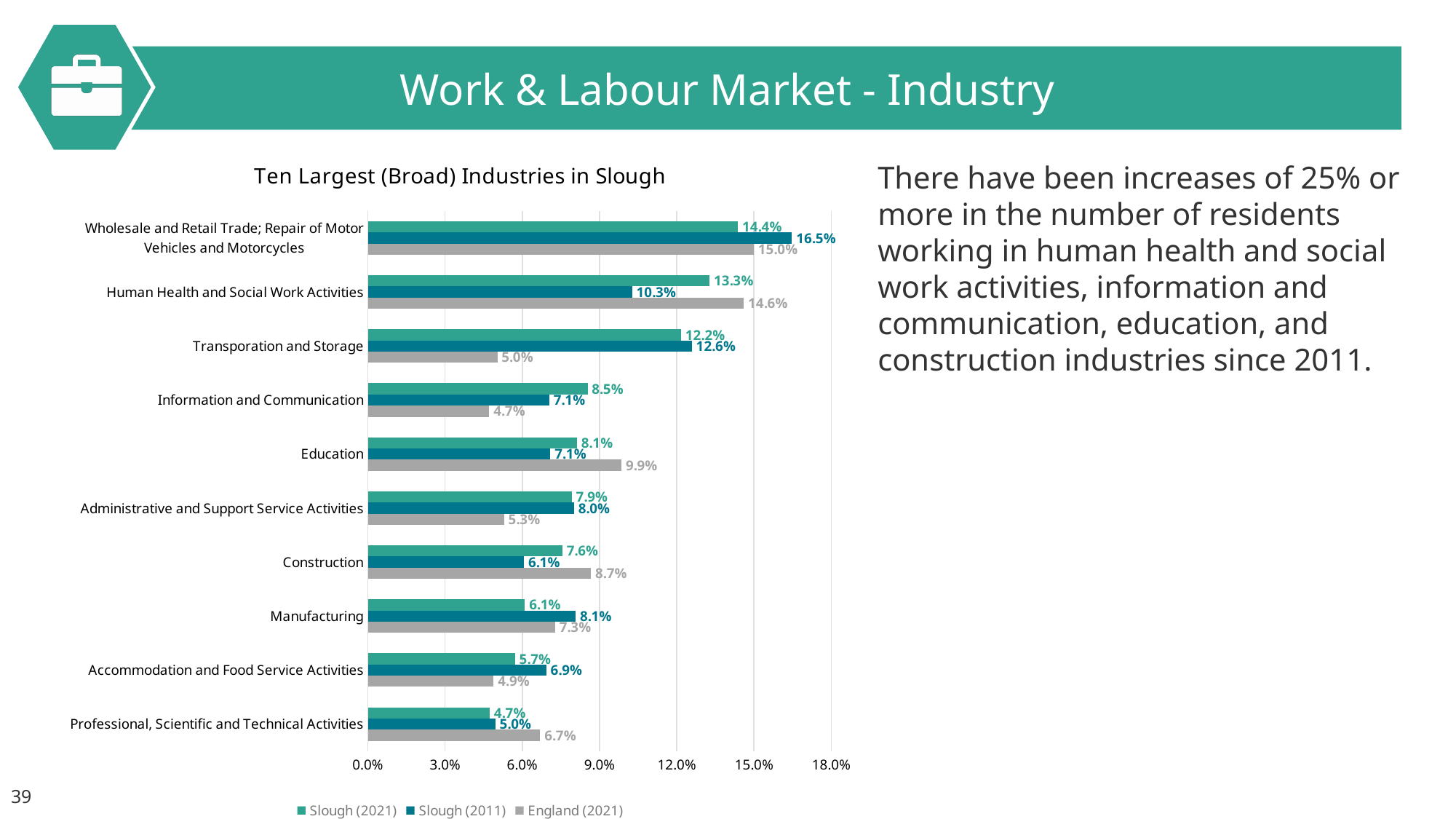
How many series does the legend list? 3 Which industry has the highest Slough (2021) value? Wholesale and Retail Trade; Repair of Motor Vehicles and Motorcycles What is the England (2021) value for Transporation and Storage? 5.0% Which is larger for Education: the Slough (2021) value or the England (2021) value? England (2021) What is the Slough (2021) value for Human Health and Social Work Activities? 13.3% What is the title of the chart? Ten Largest (Broad) Industries in Slough What is the difference between the Slough (2021) and Slough (2011) values for Construction? 1.5% How many industries are shown in the chart? 10 Is the Slough (2011) value for Wholesale and Retail Trade; Repair of Motor Vehicles and Motorcycles greater or less than 15.0%? greater What is the Slough (2011) value for Manufacturing? 8.1% Which industry has the lowest England (2021) value? Information and Communication What kind of chart is shown on the slide? Bar chart